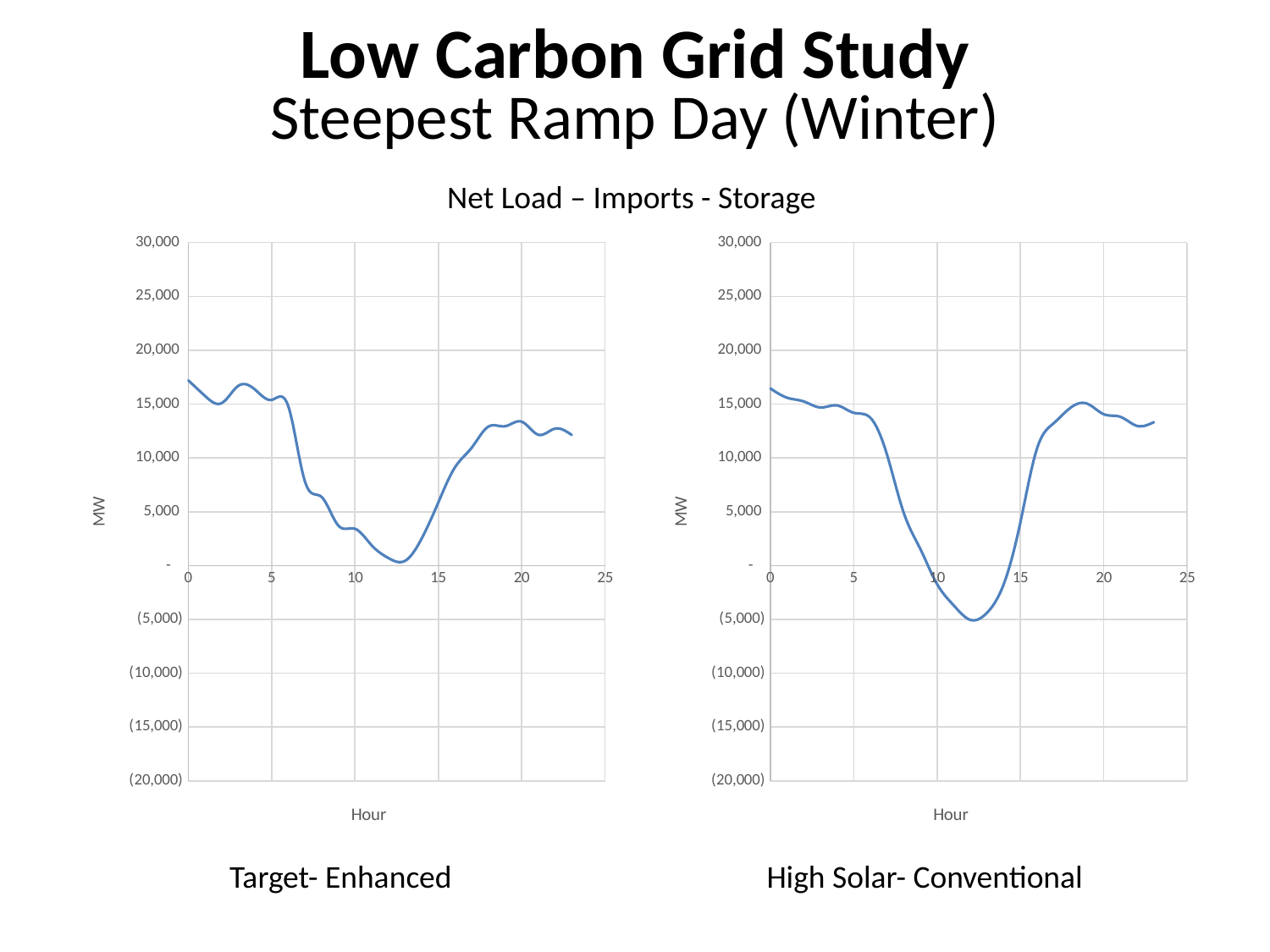
In the Target- Enhanced chart, does the line rise or fall between hour 0 and hour 13? fall In the High Solar- Conventional chart, is the value at hour 0 greater or less than 15,000? greater What is the label on the horizontal axis of both charts? Hour In the High Solar- Conventional chart, does the line rise or fall between hour 12 and hour 19? rise Which of the two charts has a line that drops below 0 MW? High Solar- Conventional What kind of chart is the Target- Enhanced chart on the left? line chart What is the label on the vertical axis of both charts? MW In the Target- Enhanced chart, is the value at hour 0 greater or less than 15,000? greater In the High Solar- Conventional chart, is the value at hour 20 greater or less than 15,000? less Which chart reaches a lower minimum value, Target- Enhanced or High Solar- Conventional? High Solar- Conventional